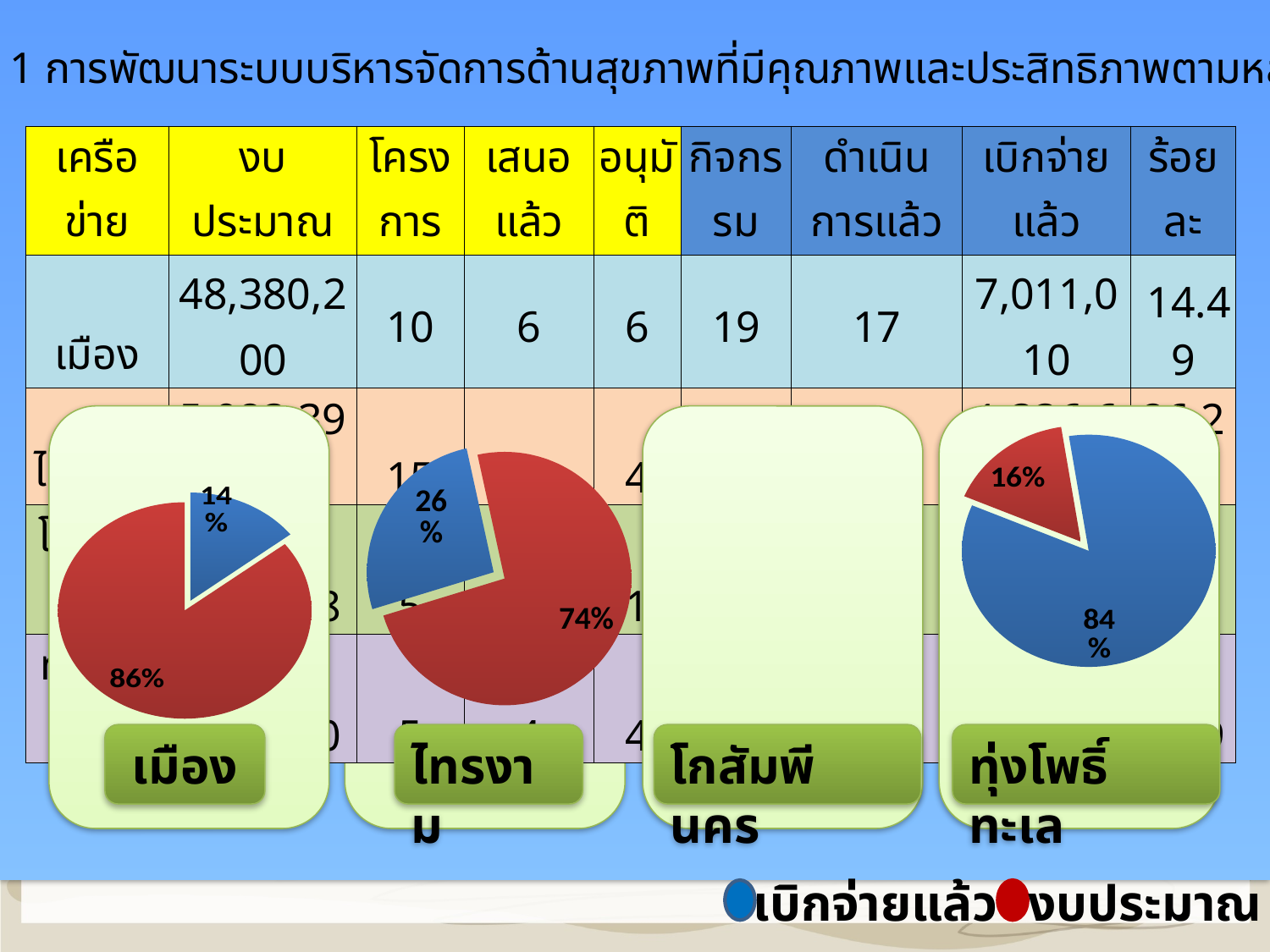
In the ไทรงาม pie chart, what percentage is shown for the red slice? 74% According to the legend at the bottom of the slide, which series is shown in blue? เบิกจ่ายแล้ว According to the legend at the bottom of the slide, which series is shown in red? งบประมาณ In the เมือง pie chart, what percentage is shown for the red slice? 86% In the ทุ่งโพธิ์ทะเล pie chart, what percentage is shown for the blue slice? 84% In the เมือง pie chart, what percentage is shown for the blue slice? 14% In the ทุ่งโพธิ์ทะเล pie chart, what percentage is shown for the red slice? 16% In the ไทรงาม pie chart, what percentage is shown for the blue slice? 26% What kind of chart is used for เมือง, ไทรงาม and ทุ่งโพธิ์ทะเล? pie chart How many slices does the ไทรงาม pie chart have? 2 In the ไทรงาม pie chart, what is the difference between the red slice and the blue slice? 48% In the เมือง pie chart, which slice is larger, the blue one or the red one? red